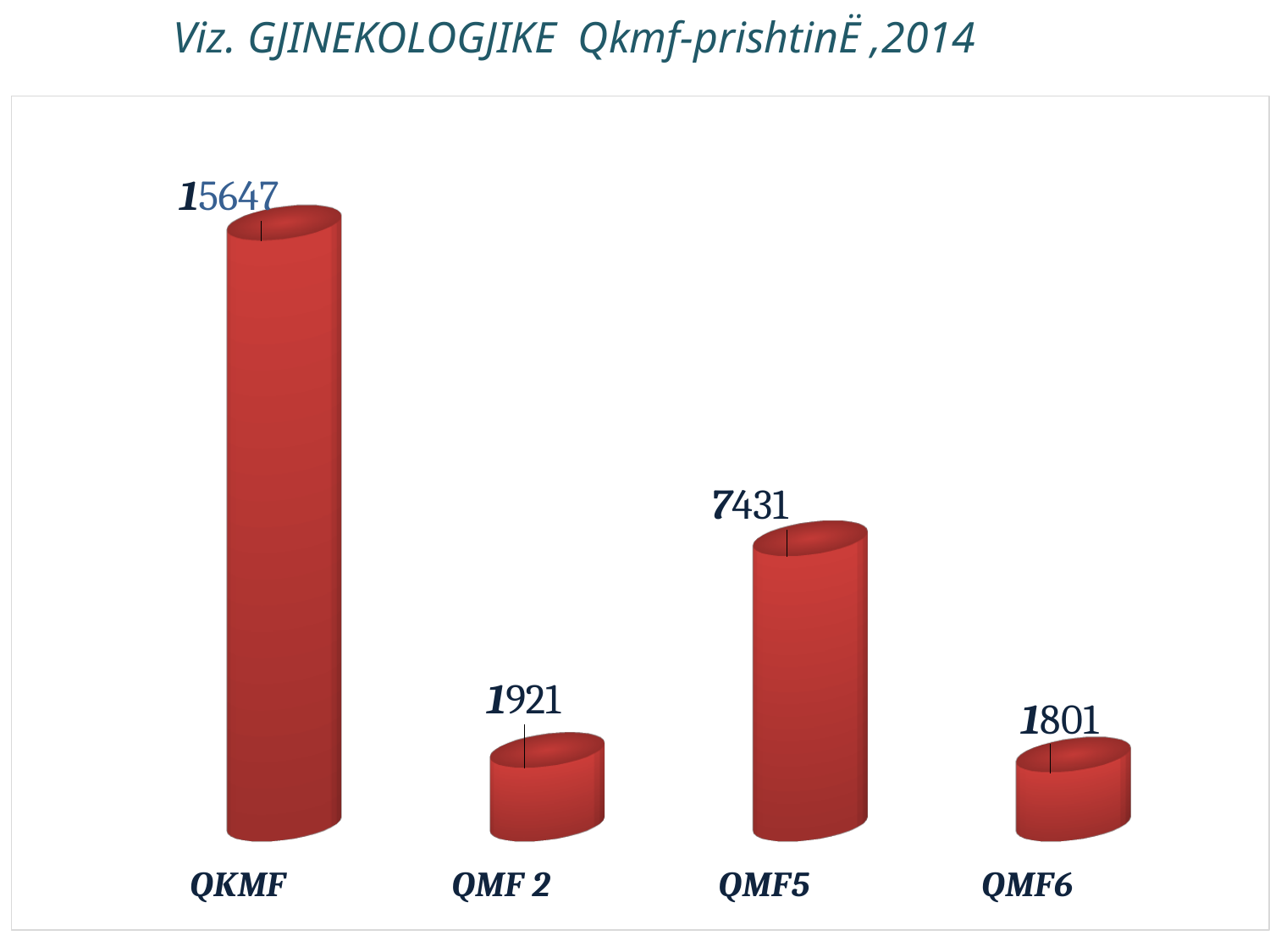
What is the difference between the values for QKMF and QMF5? 8216 How many categories are shown in the chart? 4 Which category has the highest value? QKMF What is the difference between the values for QMF 2 and QMF6? 120 What is the value for QMF 2? 1921 Which category has the lowest value? QMF6 Which is larger, the value for QMF5 or the value for QMF 2? QMF5 What is the value for QMF6? 1801 What is the title of the chart? Viz. GJINEKOLOGJIKE Qkmf-prishtinË ,2014 What is the value for QMF5? 7431 What is the value for QKMF? 15647 What kind of chart is shown on the slide? Bar chart